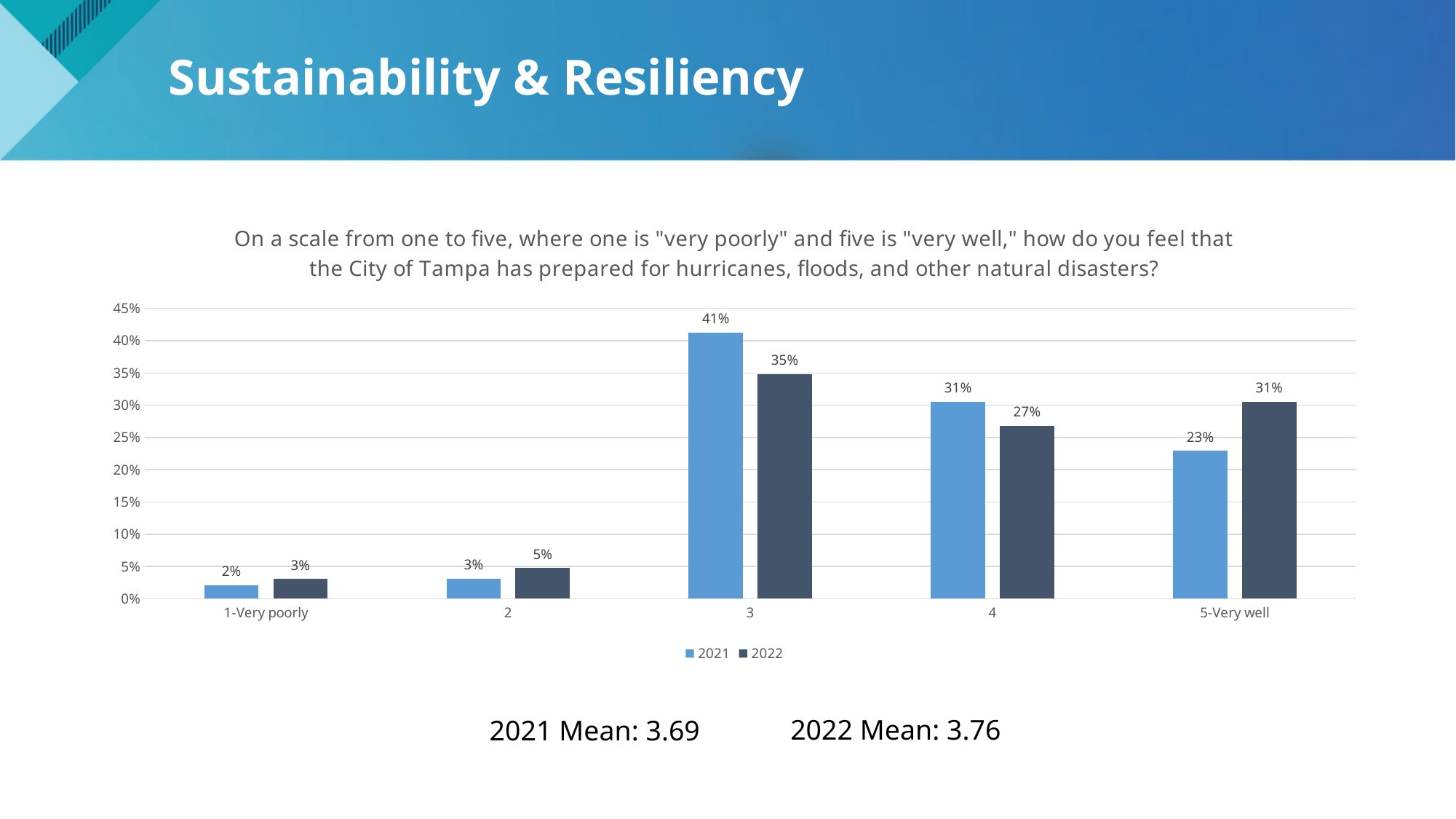
What is the 2021 value for the "1-Very poorly" category? 2% How many series does the legend list? 2 What is the 2022 mean shown below the chart? 3.76 Which is larger for category 4: the 2021 value or the 2022 value? 2021 What kind of chart is shown on the slide? Bar chart How many rating categories are shown on the x axis? 5 Which category has the lowest value for the 2021 series? 1-Very poorly Which category has the highest value for the 2022 series? 3 What is the difference between the 2022 and 2021 values for "5-Very well"? 8% What is the 2022 value for the "5-Very well" category? 31% What percentage of respondents rated the City of Tampa's preparedness as 3 in 2021? 41% What is the difference between the 2021 and 2022 values for category 3? 6%